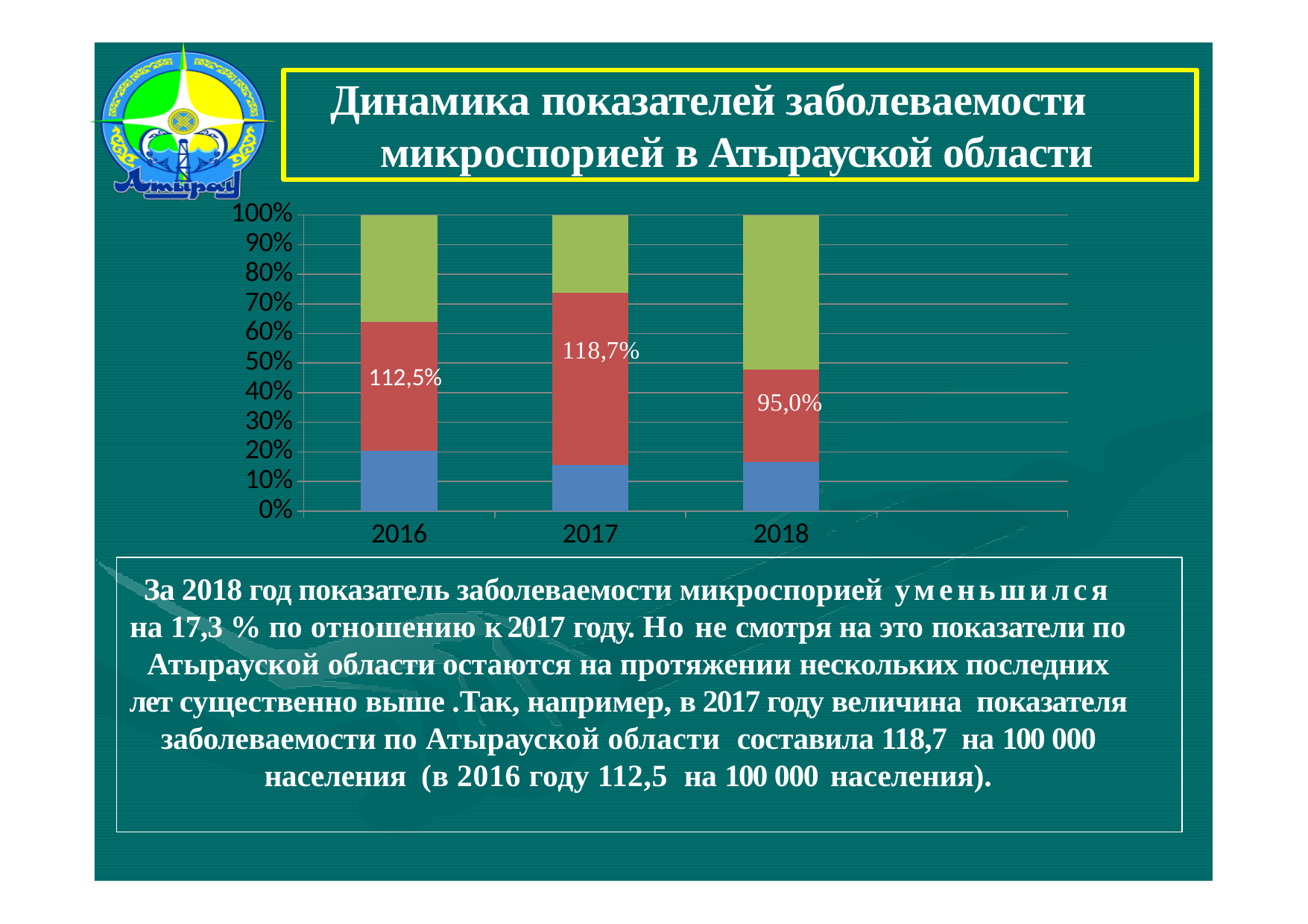
What is the data label shown on the red segment of the 2018 bar? 95,0% Which year has the lowest labelled value on its red segment? 2018 What is the data label shown on the red segment of the 2016 bar? 112,5% What is the data label shown on the red segment of the 2017 bar? 118,7% What is the difference between the labelled values for 2017 and 2018? 23,7% What kind of chart is shown on the slide? stacked bar chart What is the title of the chart on the slide? Динамика показателей заболеваемости микроспорией в Атырауской области Is the top of the red segment in the 2017 bar greater or less than 70%? greater Which is larger, the labelled value for 2016 or for 2018? 2016 Which year has the highest labelled value on its red segment? 2017 How many years are shown on the x axis of the chart? 3 Is the top of the blue segment in the 2017 bar greater or less than 20%? less